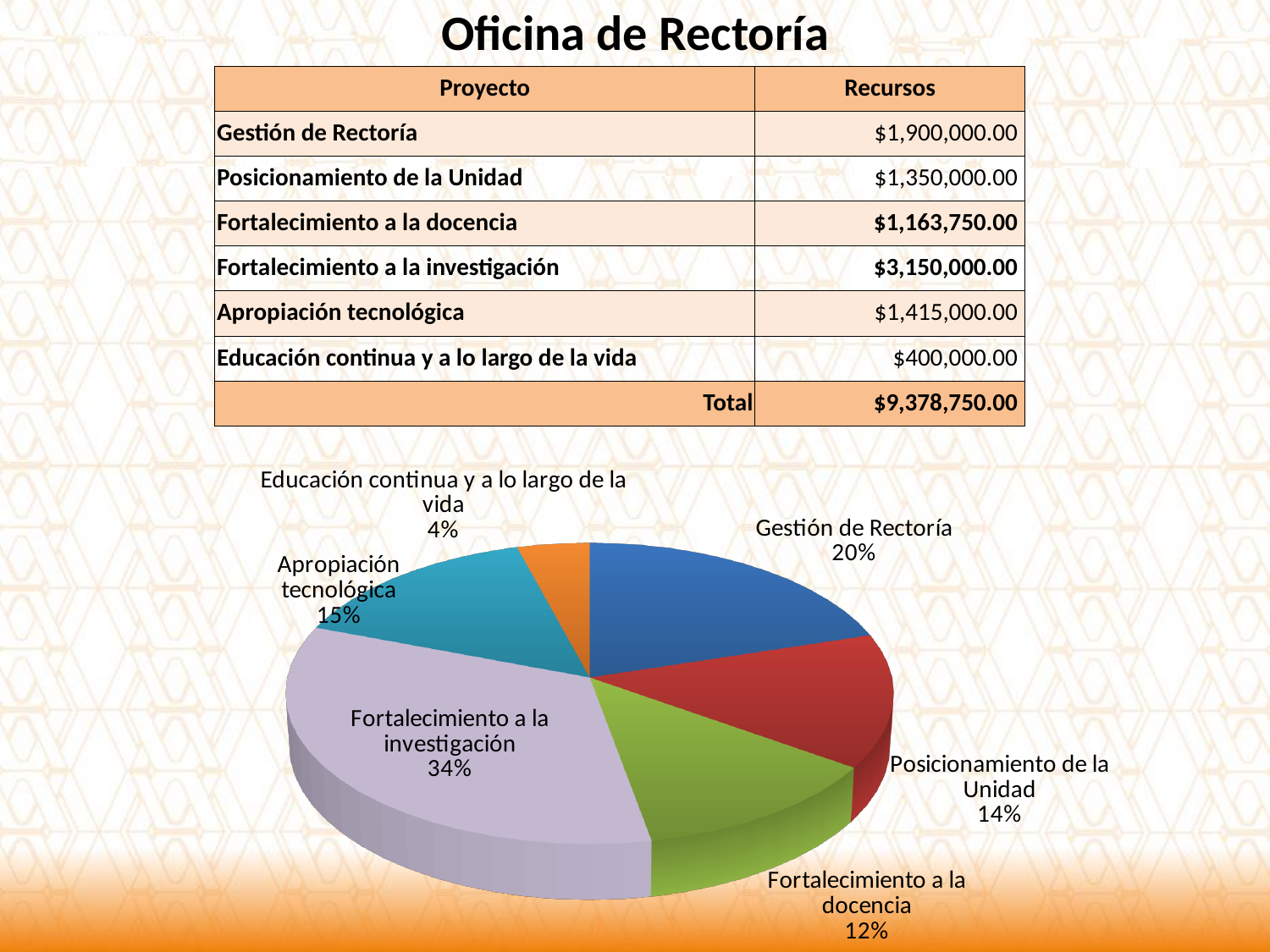
What colour is the Fortalecimiento a la investigación slice in the pie chart? light purple What kind of chart is shown on the slide? pie chart What is the difference in percentage points between the Fortalecimiento a la investigación slice and the Fortalecimiento a la docencia slice? 22 What share of the pie does Apropiación tecnológica represent? 15% Which slice is larger, Posicionamiento de la Unidad or Apropiación tecnológica? Apropiación tecnológica What share of the pie does Educación continua y a lo largo de la vida represent? 4% Which slice of the pie chart is the smallest? Educación continua y a lo largo de la vida Which slice of the pie chart is the largest? Fortalecimiento a la investigación What share of the pie does Gestión de Rectoría represent? 20% How many slices does the pie chart have? 6 Which slice is larger, Gestión de Rectoría or Fortalecimiento a la docencia? Gestión de Rectoría